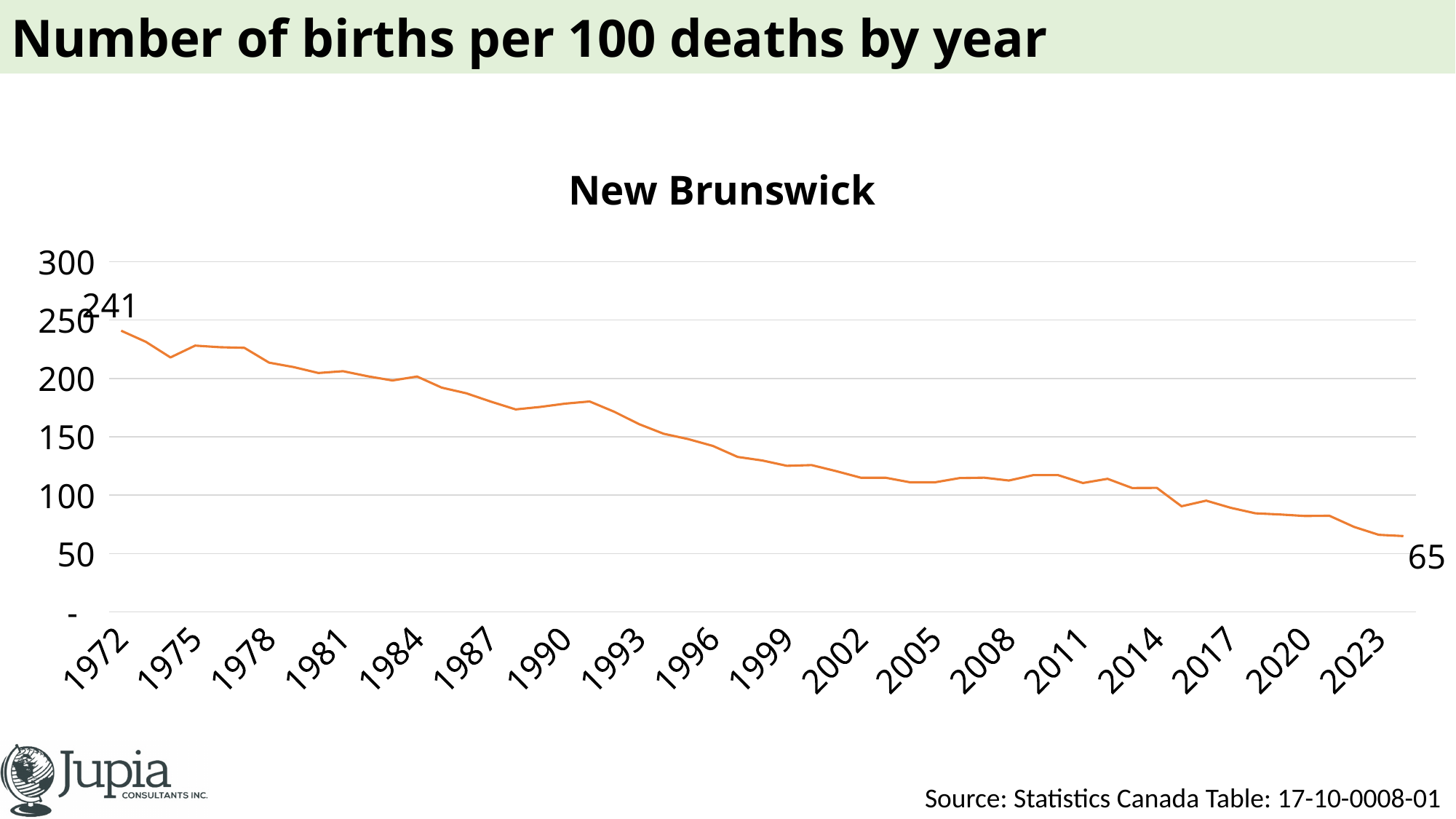
What is the number of births per 100 deaths in New Brunswick in 1972? 241 Which year has the lowest number of births per 100 deaths? 2024 Which province does the chart show data for? New Brunswick What is the source cited for the chart data? Statistics Canada Table: 17-10-0008-01 Is the value for 1990 greater or less than 150? greater Is the value for 1999 greater or less than 150? less What type of chart is shown on the slide? line chart Does the number of births per 100 deaths generally rise or fall from 1972 to 2023? fall Is the value for 2017 greater or less than 100? less Which year has the highest number of births per 100 deaths? 1972